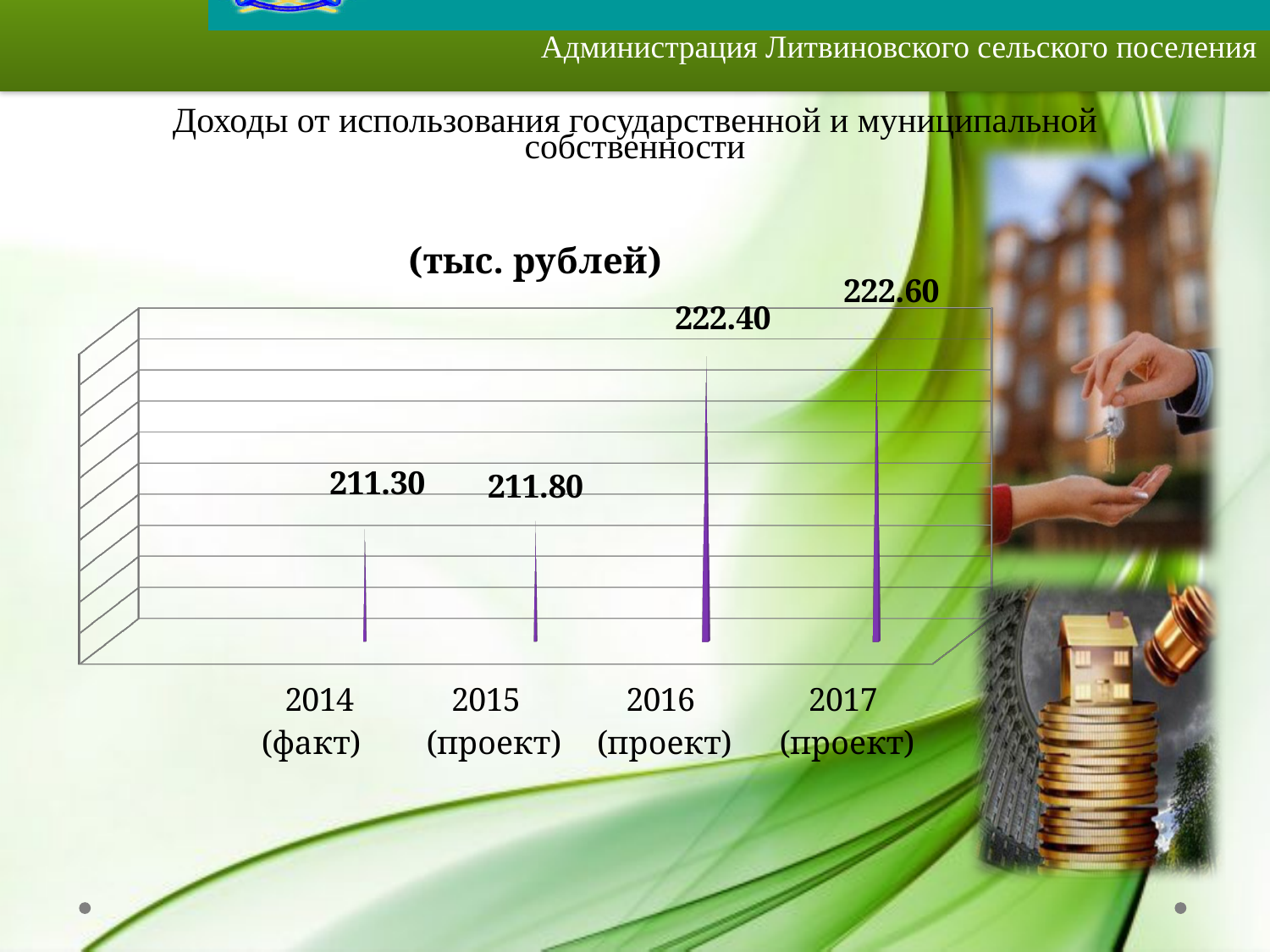
Which category has the lowest value? 2014 (факт) What is the difference between the values for 2016 (проект) and 2014 (факт)? 11.10 What is the value for 2017 (проект)? 222.60 What is the value for 2015 (проект)? 211.80 What is the difference between the values for 2017 (проект) and 2016 (проект)? 0.20 What kind of chart is shown on the slide? bar chart Which is larger, the value for 2016 (проект) or the value for 2015 (проект)? 2016 (проект) Do the values rise or fall from 2014 to 2017? rise What is the value for 2016 (проект)? 222.40 What is the value for 2014 (факт)? 211.30 How many categories are shown on the x axis? 4 Which category has the highest value? 2017 (проект)